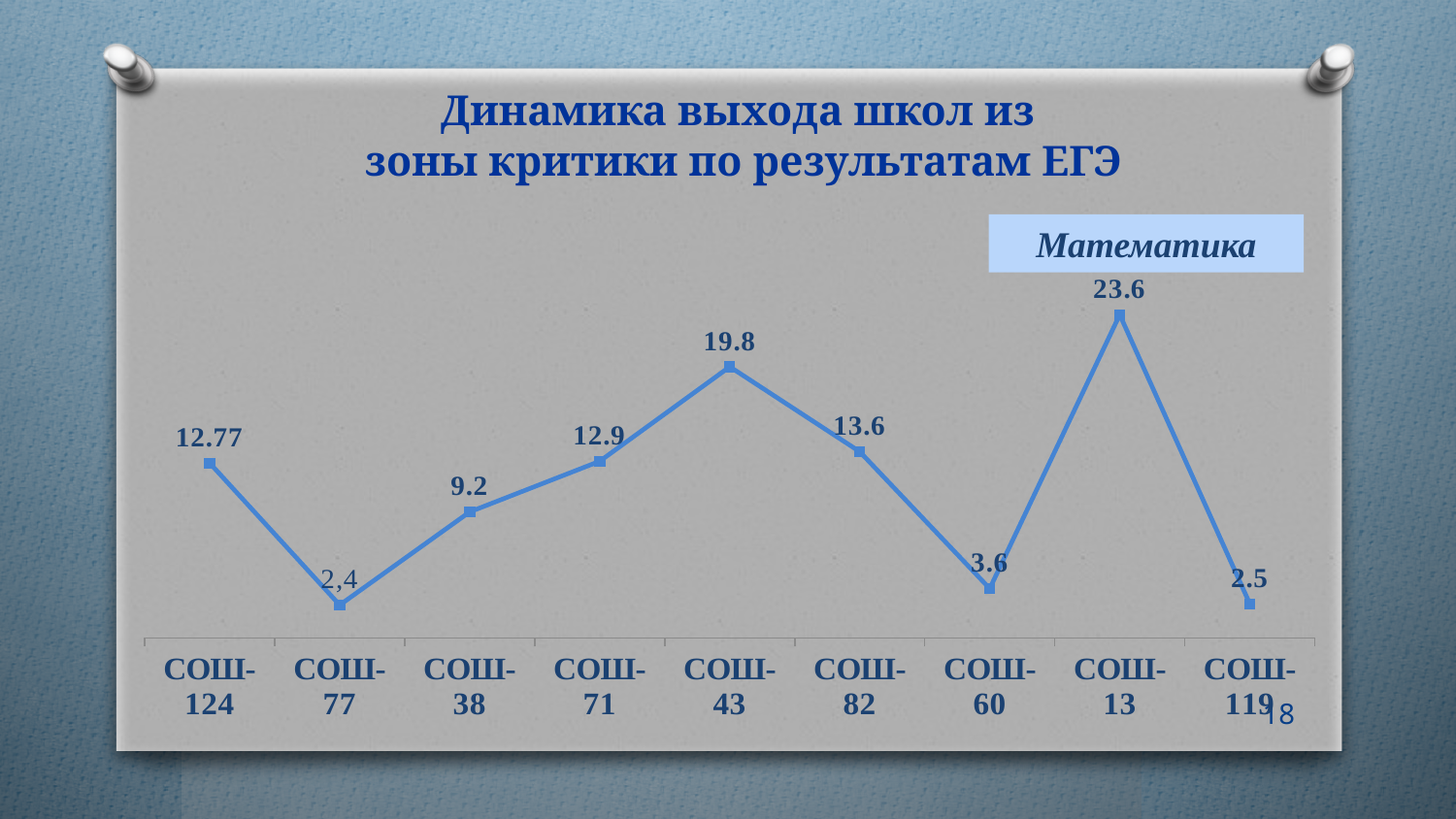
What kind of chart is shown on the slide? Line chart What is the value for СОШ-13? 23.6 What is the value for СОШ-124? 12.77 What is the value for СОШ-82? 13.6 Which school has the highest value? СОШ-13 What is the difference between the values for СОШ-13 and СОШ-43? 3.8 How many schools are plotted on the chart? 9 What is the difference between the values for СОШ-71 and СОШ-38? 3.7 Which has a larger value, СОШ-43 or СОШ-82? СОШ-43 What is the value for СОШ-77? 2,4